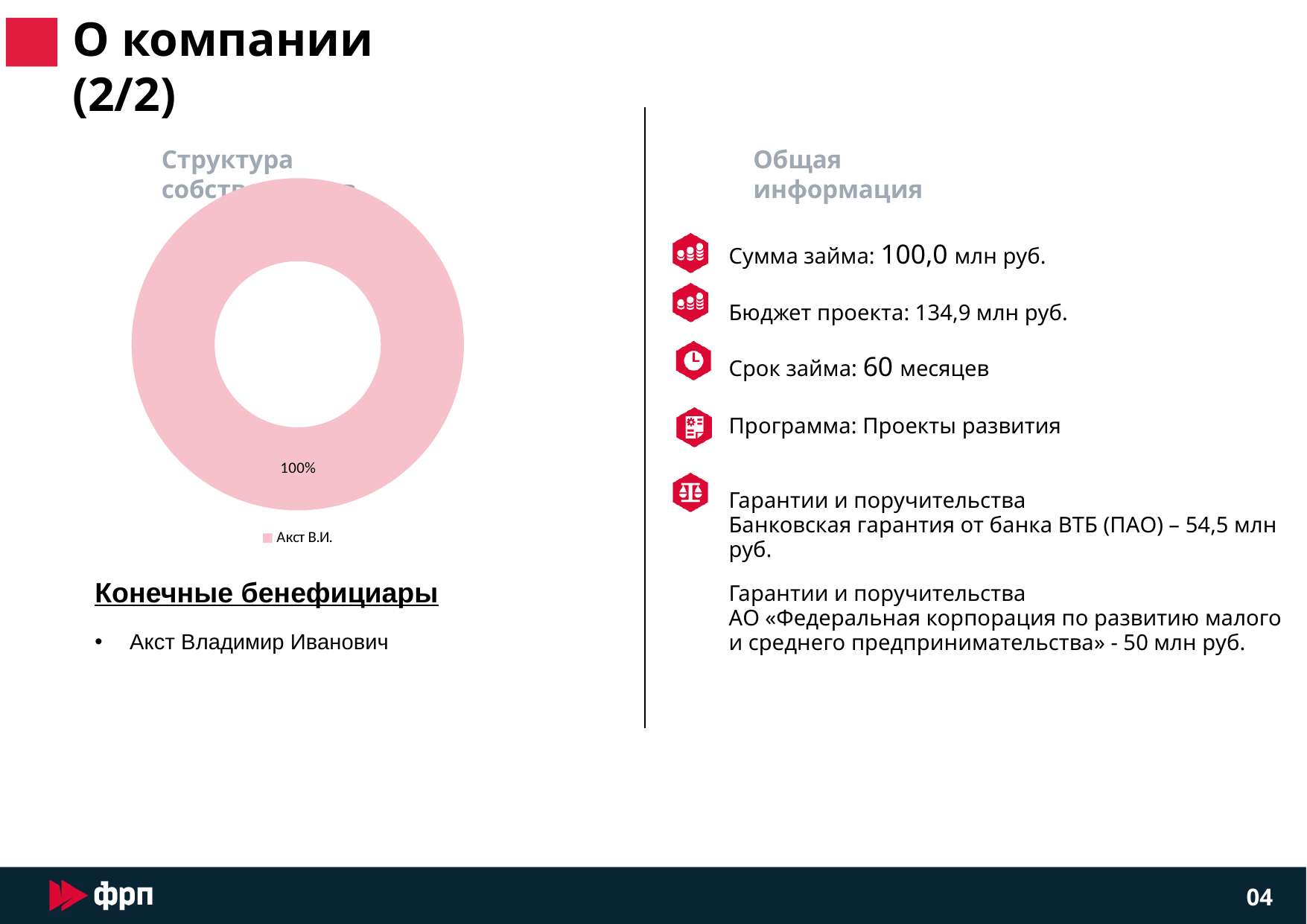
How many entries does the legend of the doughnut chart list? 1 What share of the doughnut chart does Акст В.И. hold? 100% How many slices does the doughnut chart have? 1 What colour is the slice in the doughnut chart? Pink What value is printed on the doughnut chart slice? 100% What is the name of the only category in the chart's legend? Акст В.И. What kind of chart is shown on the slide? Doughnut (pie) chart Which category has the largest share in the doughnut chart? Акст В.И.